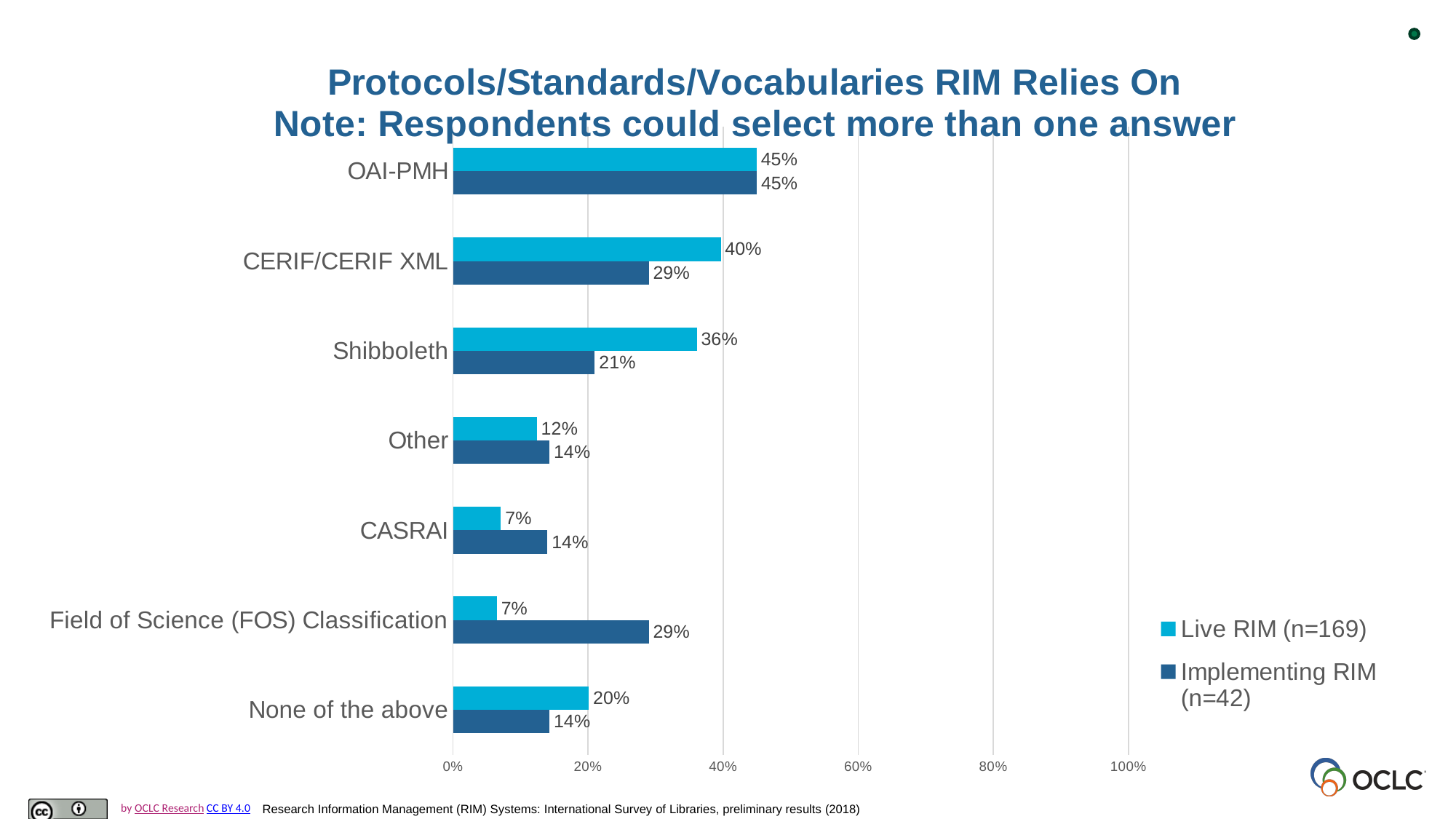
What is the Implementing RIM (n=42) value for Field of Science (FOS) Classification? 29% What kind of chart is shown on the slide? Bar chart Which category has the highest Live RIM (n=169) value? OAI-PMH What is the Live RIM (n=169) value for None of the above? 20% Which series is shown in the darker blue colour? Implementing RIM (n=42) What is the difference between the Live RIM and Implementing RIM values for Shibboleth? 15% Is the Implementing RIM (n=42) value for OAI-PMH greater or less than 40%? greater Which category has the lowest Implementing RIM (n=42) value? Other, CASRAI and None of the above (all 14%) How many categories are shown on the chart? 7 What is the Live RIM (n=169) value for Shibboleth? 36% How many series does the legend list? 2 For CERIF/CERIF XML, which series has the larger value, Live RIM (n=169) or Implementing RIM (n=42)? Live RIM (n=169)